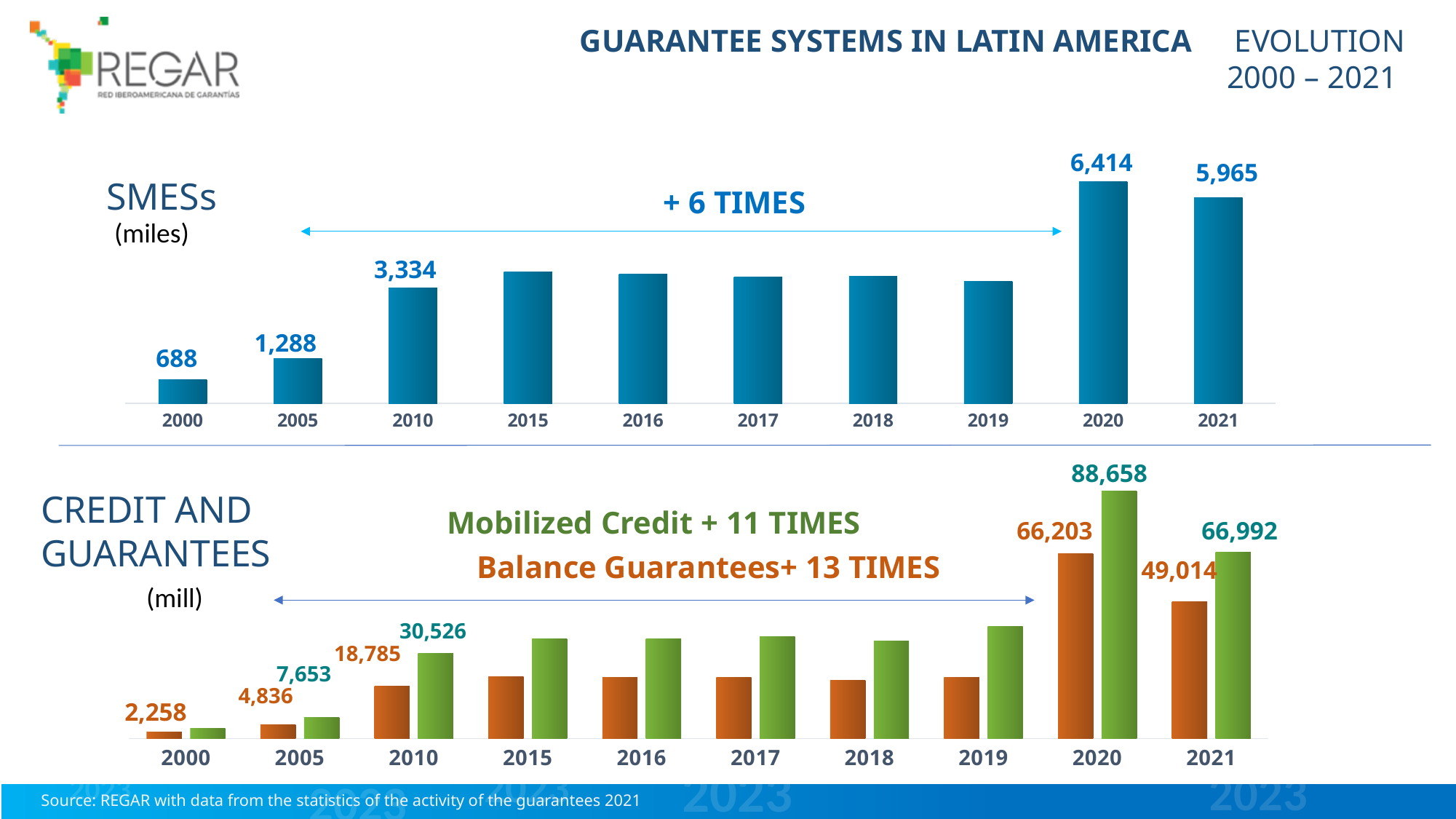
In the Credit and Guarantees chart, what is the Balance Guarantees (orange) value for 2010? 18,785 In the SMESs chart, what is the difference between the 2020 and 2021 values? 449 In the Credit and Guarantees chart, how many data series are plotted? 2 In the SMESs chart, which year has the highest value? 2020 In the SMESs chart, how many years are shown on the x axis? 10 What kind of chart is the SMESs chart? Bar chart In the Credit and Guarantees chart, what is the Mobilized Credit (green) value for 2020? 88,658 In the SMESs chart, what is the value for 2020? 6,414 In the SMESs chart, what is the value for 2000? 688 In the Credit and Guarantees chart, which is larger in 2021: Mobilized Credit or Balance Guarantees? Mobilized Credit In the SMESs chart, which year has the lowest value? 2000 In the Credit and Guarantees chart, what is the difference between the Mobilized Credit and Balance Guarantees values in 2005? 2,817